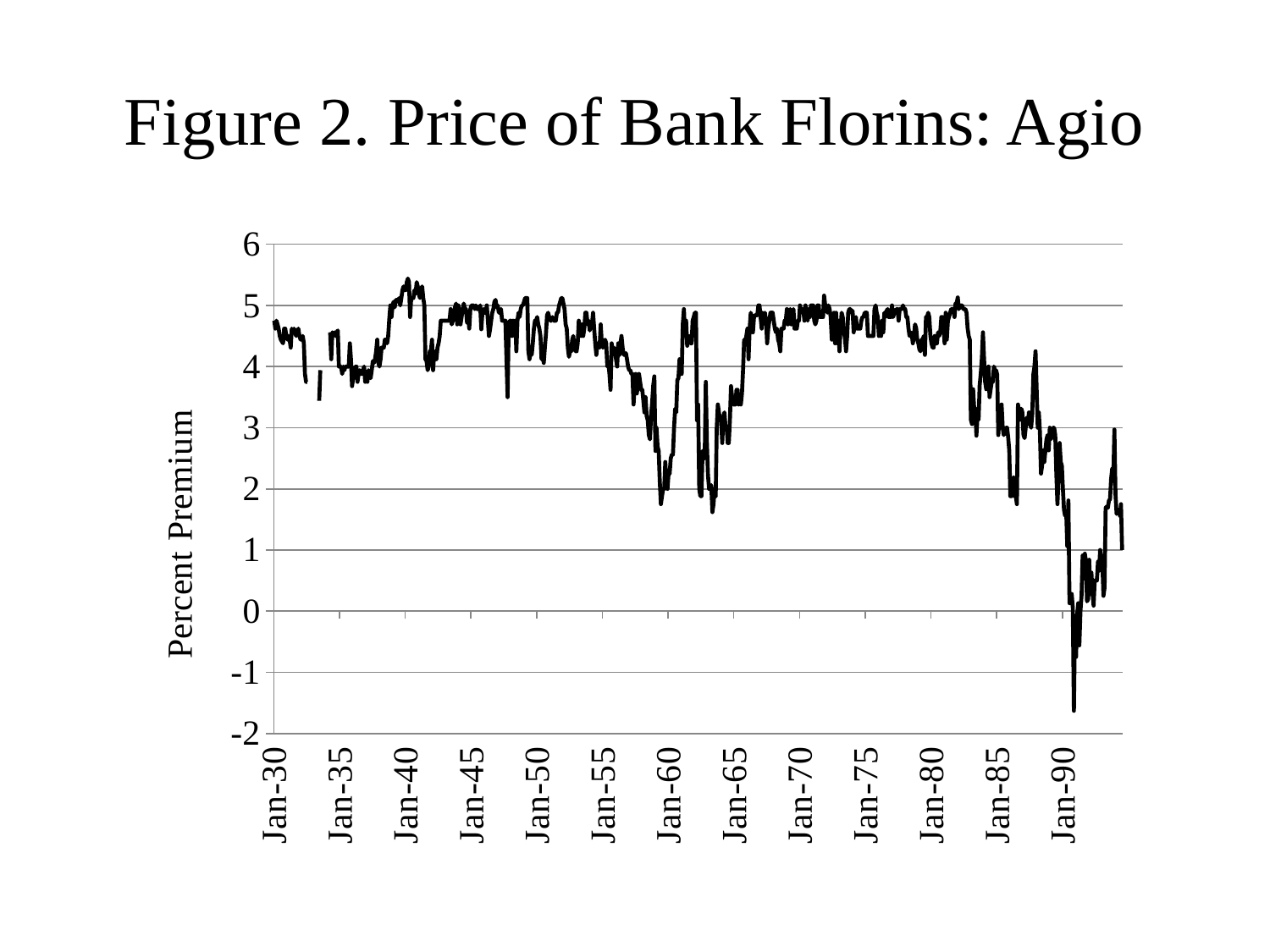
What is the label on the vertical axis of the chart? Percent Premium Is the value at Jan-70 greater or less than 4? greater Is the value at Jan-50 greater or less than 3? greater What kind of chart is shown on the slide? line chart What is the title of the chart? Figure 2. Price of Bank Florins: Agio How many year labels are shown on the horizontal axis? 13 Overall, does the percent premium rise or fall from Jan-30 to the end of the series? fall Is the value at Jan-90 greater or less than 3? less Around which labelled year does the line reach its lowest point? Jan-90